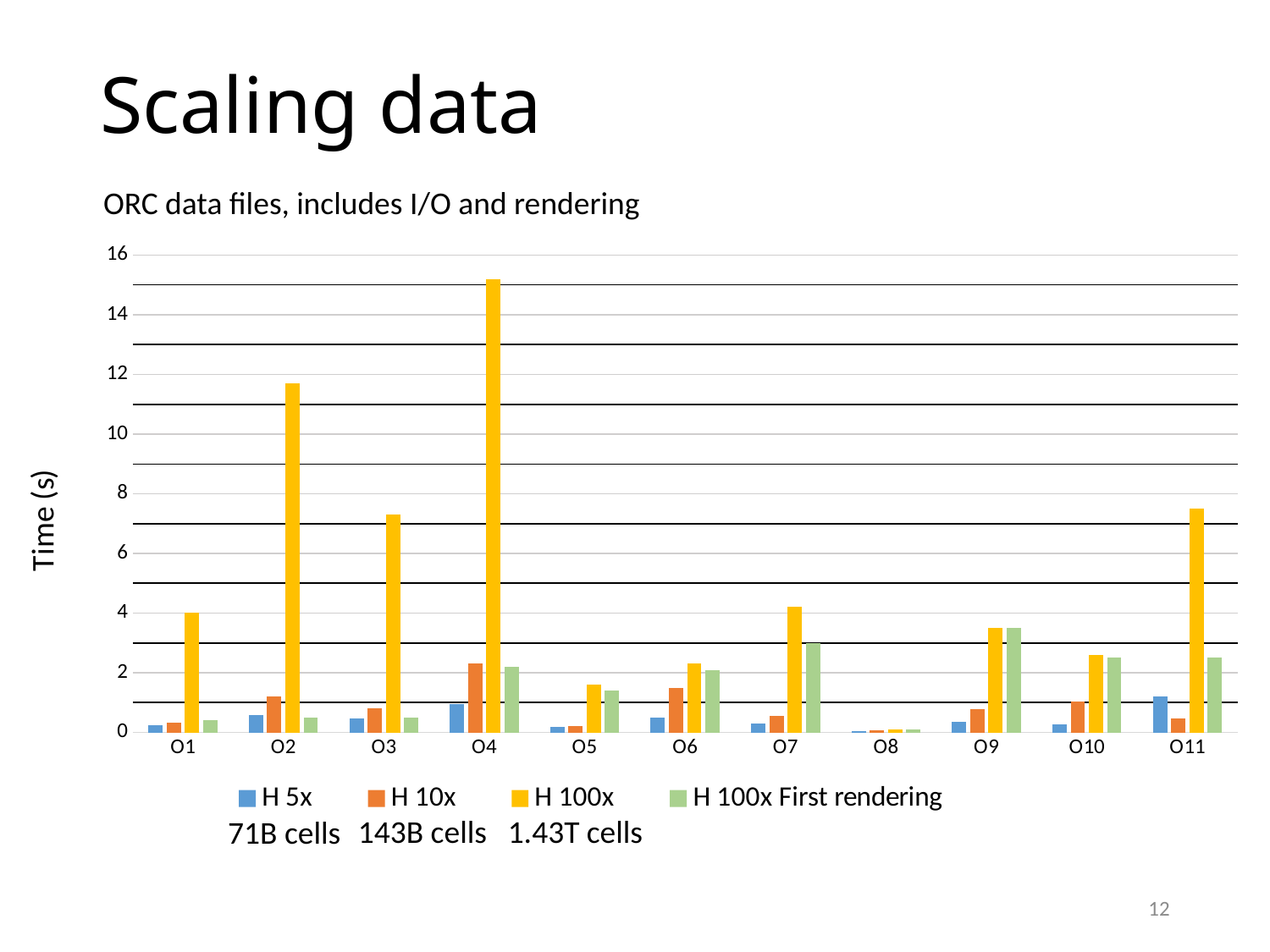
What is the label of the y axis? Time (s) What kind of chart is shown on the slide? bar chart Which is larger, the H 100x value for O11 or for O1? O11 Which category has the lowest H 100x value? O8 Which category has the highest H 100x First rendering value? O9 Which is larger, the H 100x value for O2 or for O3? O2 How many series does the legend list? 4 Which category has the highest H 100x value? O4 Is the H 100x value for O4 greater or less than 14? greater How many categories are shown along the x axis? 11 Is the H 100x value for O3 greater or less than 8? less Is the H 100x value for O2 greater or less than 10? greater